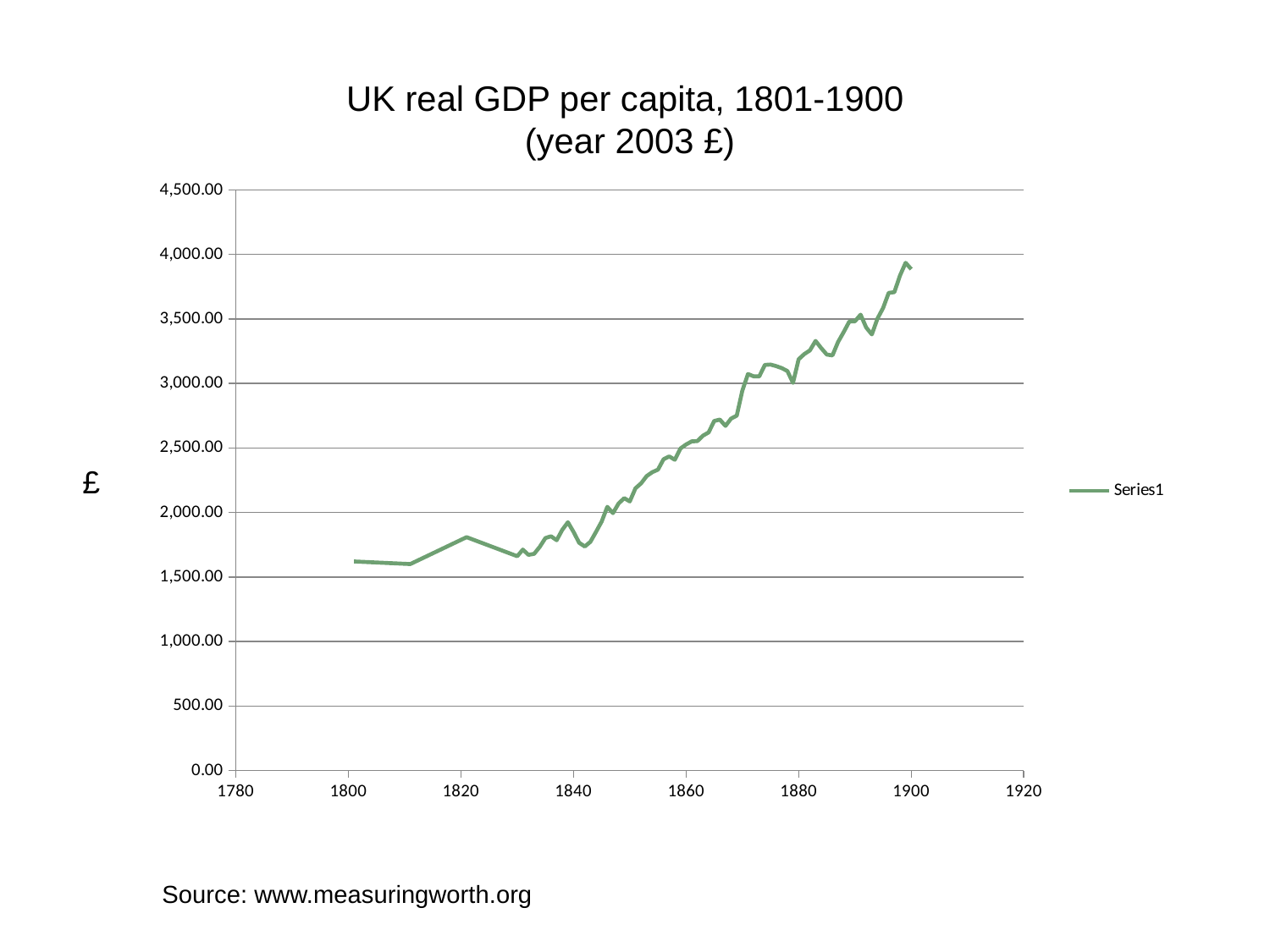
Is the value for 1900 greater or less than 3,500.00? greater Which is larger, the value for 1840 or the value for 1880? 1880 Is the value for 1801 greater or less than 1,500.00? greater Is the value for 1850 greater or less than 2,000.00? greater Overall, do the values rise or fall from 1800 to 1900? rise What kind of chart is shown on the slide? line chart How many series does the legend list? 1 What is the title of the chart? UK real GDP per capita, 1801-1900 (year 2003 £) What is the name of the series shown in the legend? Series1